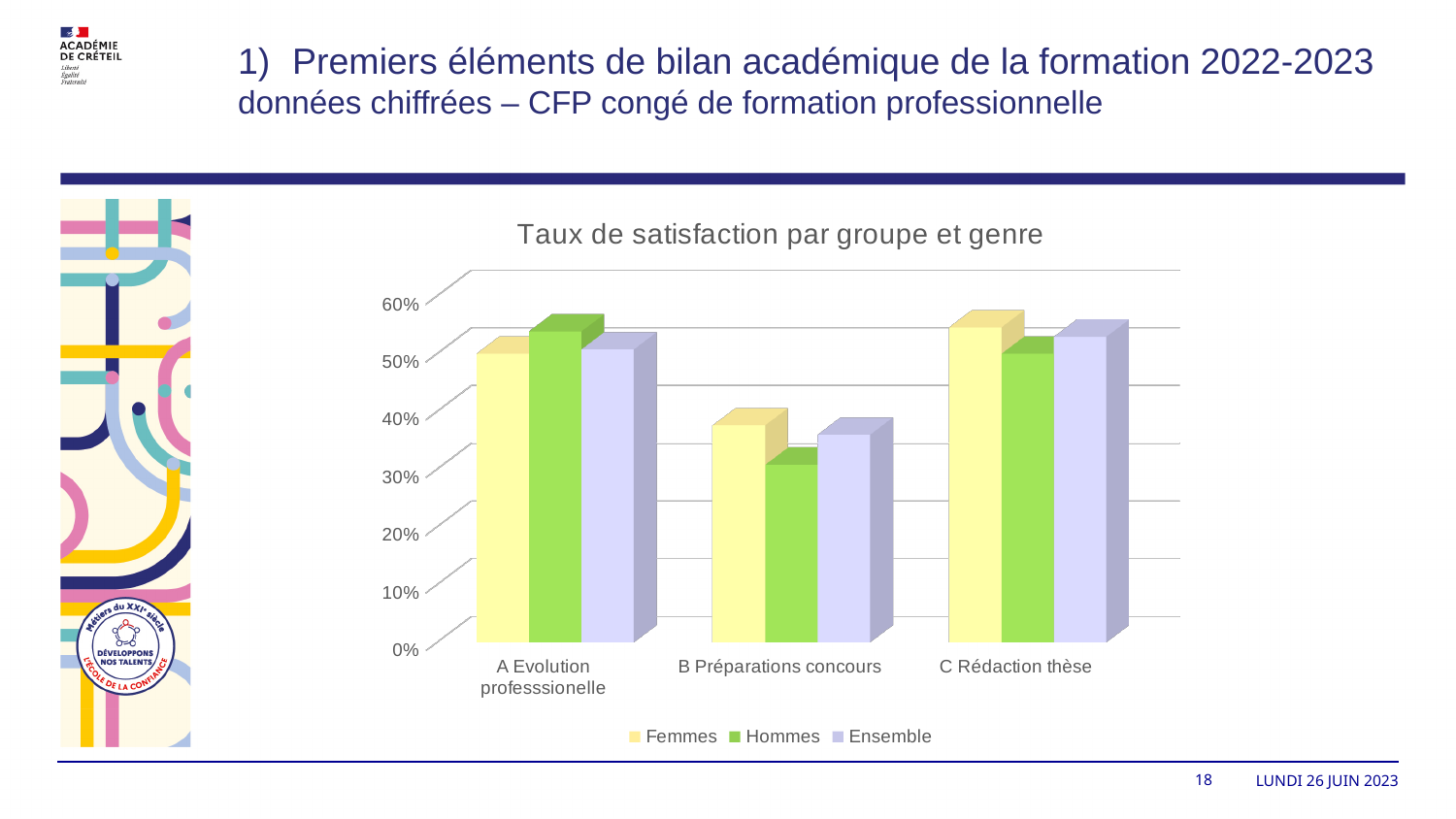
Is the Femmes value for A Evolution professsionelle greater or less than 40%? greater Which series are listed in the legend? Femmes, Hommes, Ensemble For the Femmes series, which is larger: C Rédaction thèse or B Préparations concours? C Rédaction thèse Is the Hommes value for B Préparations concours greater or less than 40%? less What kind of chart is shown on the slide? bar chart How many categories are shown on the x axis? 3 In the category B Préparations concours, which is larger: Femmes or Hommes? Femmes How many series does the legend list? 3 For the Hommes series, which category has the lowest value? B Préparations concours Is the Femmes value for C Rédaction thèse greater or less than 50%? greater What is the title of the chart? Taux de satisfaction par groupe et genre For the Ensemble series, which category has the lowest value? B Préparations concours